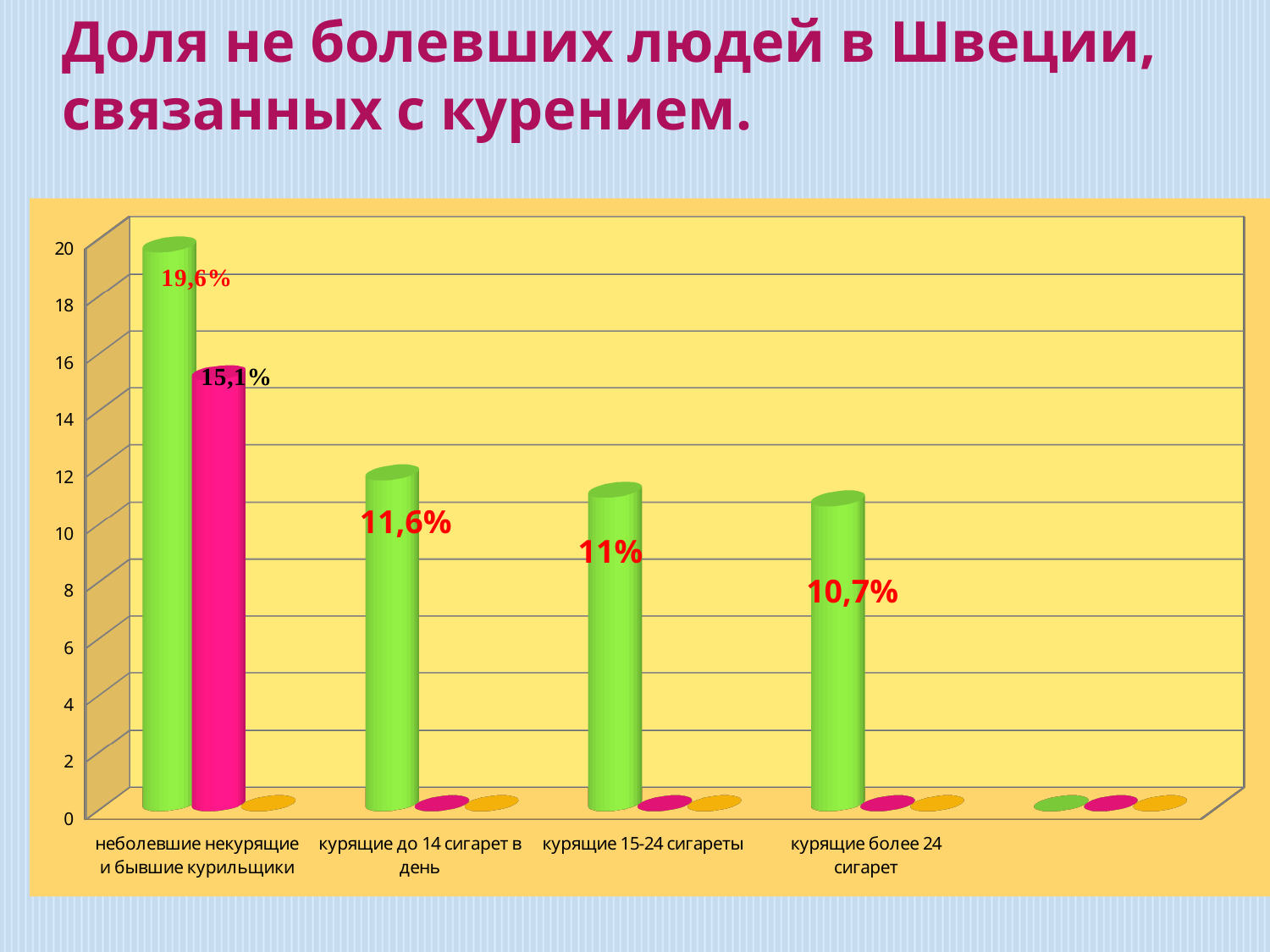
What is the difference between the green bar (19,6%) and the pink bar (15,1%) in the first category? 4,5% Do the values of the green bars rise or fall from left to right across the categories? Fall Which is larger: the value for "курящие до 14 сигарет в день" or for "курящие 15-24 сигареты"? курящие до 14 сигарет в день What value is shown for the pink bar in the category "неболевшие некурящие и бывшие курильщики"? 15,1% Which category has the highest value on the chart? неболевшие некурящие и бывшие курильщики What value is shown for "курящие до 14 сигарет в день"? 11,6% Which labeled category has the lowest value on the chart? курящие более 24 сигарет What is the title of the chart on the slide? Доля не болевших людей в Швеции, связанных с курением. What value is shown for the green bar in the category "неболевшие некурящие и бывшие курильщики"? 19,6% What kind of chart is shown on the slide? Bar chart What value is shown for "курящие 15-24 сигареты"? 11% What value is shown for "курящие более 24 сигарет"? 10,7%